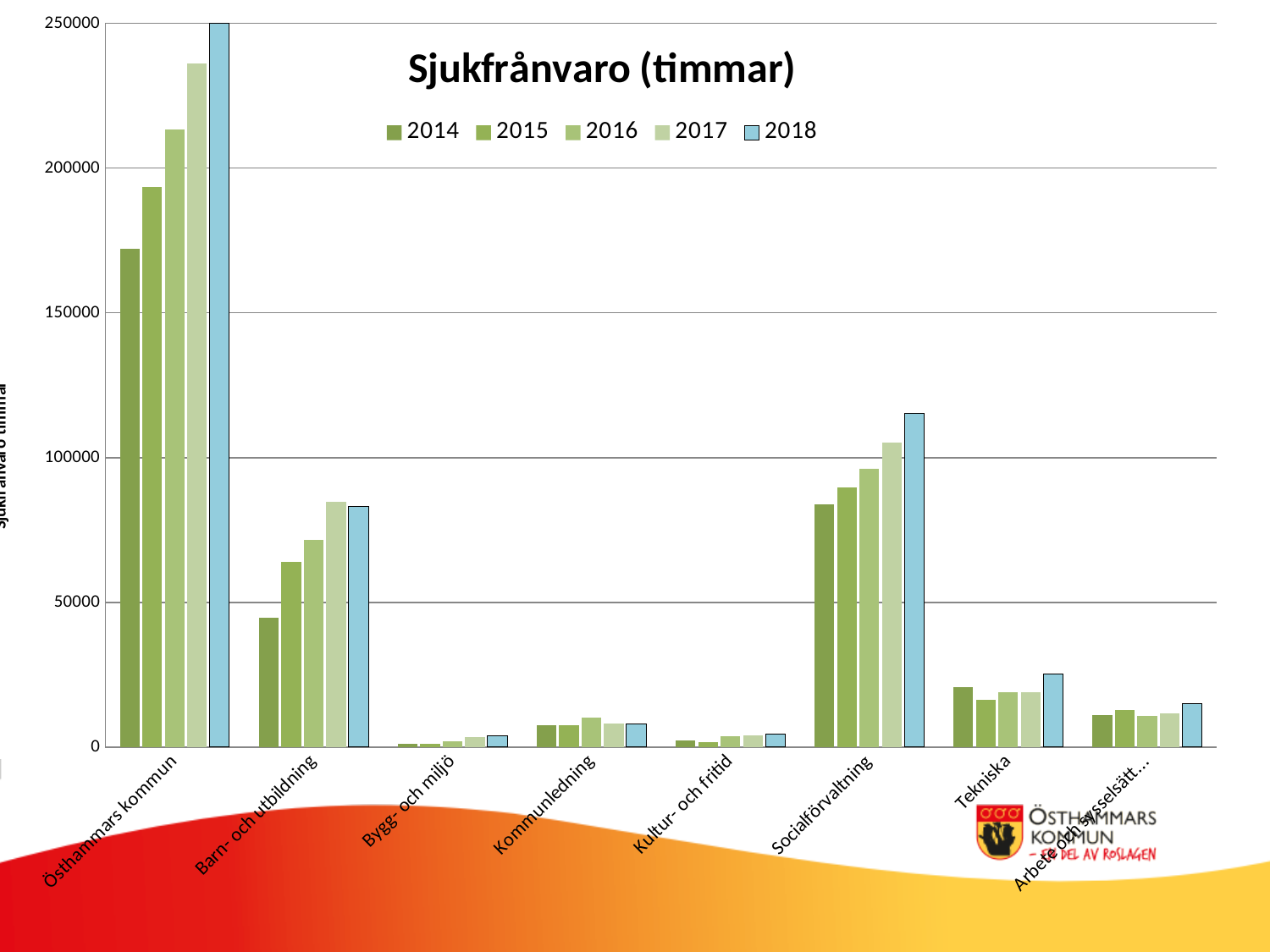
Is the 2014 value for Barn- och utbildning greater or less than 50000? less What kind of chart is shown on the slide? bar chart Is the 2018 value for Socialförvaltning greater or less than 100000? greater Is the 2014 value for Östhammars kommun greater or less than 150000? greater How many categories are shown along the x axis? 8 Which category has the highest bars in the chart? Östhammars kommun How many series does the legend list? 5 Which has the larger 2018 value, Socialförvaltning or Barn- och utbildning? Socialförvaltning What is the title of the chart? Sjukfrånvaro (timmar) Do the values for Östhammars kommun rise or fall from 2014 to 2018? rise Which category has the lowest bars in the chart? Bygg- och miljö Do the values for Socialförvaltning rise or fall from 2014 to 2018? rise